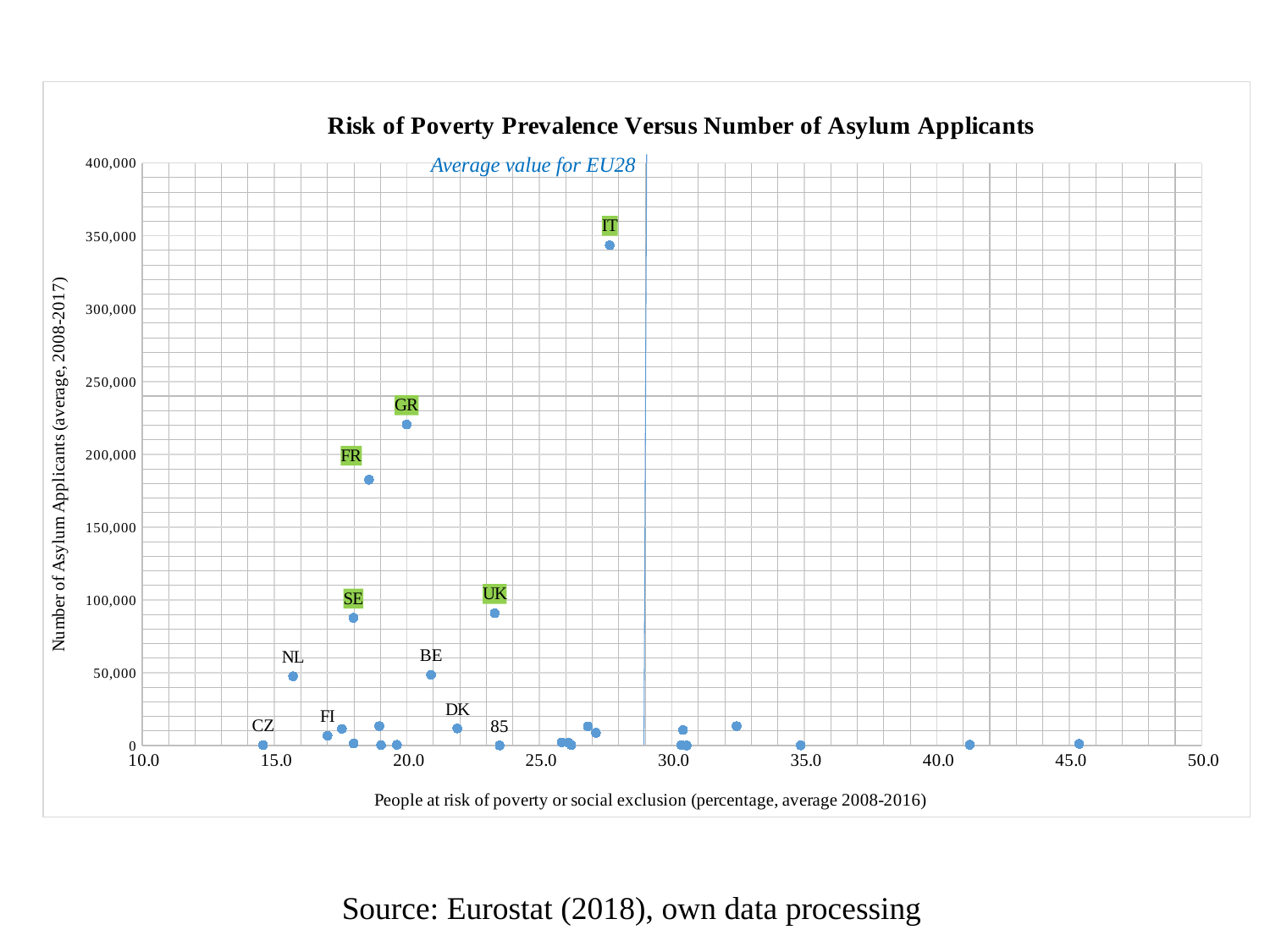
Which labelled country has the lowest number of asylum applicants? CZ What kind of chart is shown on the slide? scatter chart Which has a higher share of people at risk of poverty or social exclusion, IT or NL? IT Is the number of asylum applicants for FR greater or less than 200,000? less Is the number of asylum applicants for IT greater or less than 300,000? greater What does the vertical line on the chart represent, according to its label? Average value for EU28 Is the number of asylum applicants for GR greater or less than 200,000? greater Which has more asylum applicants, GR or FR? GR Which labelled country has the highest number of asylum applicants? IT